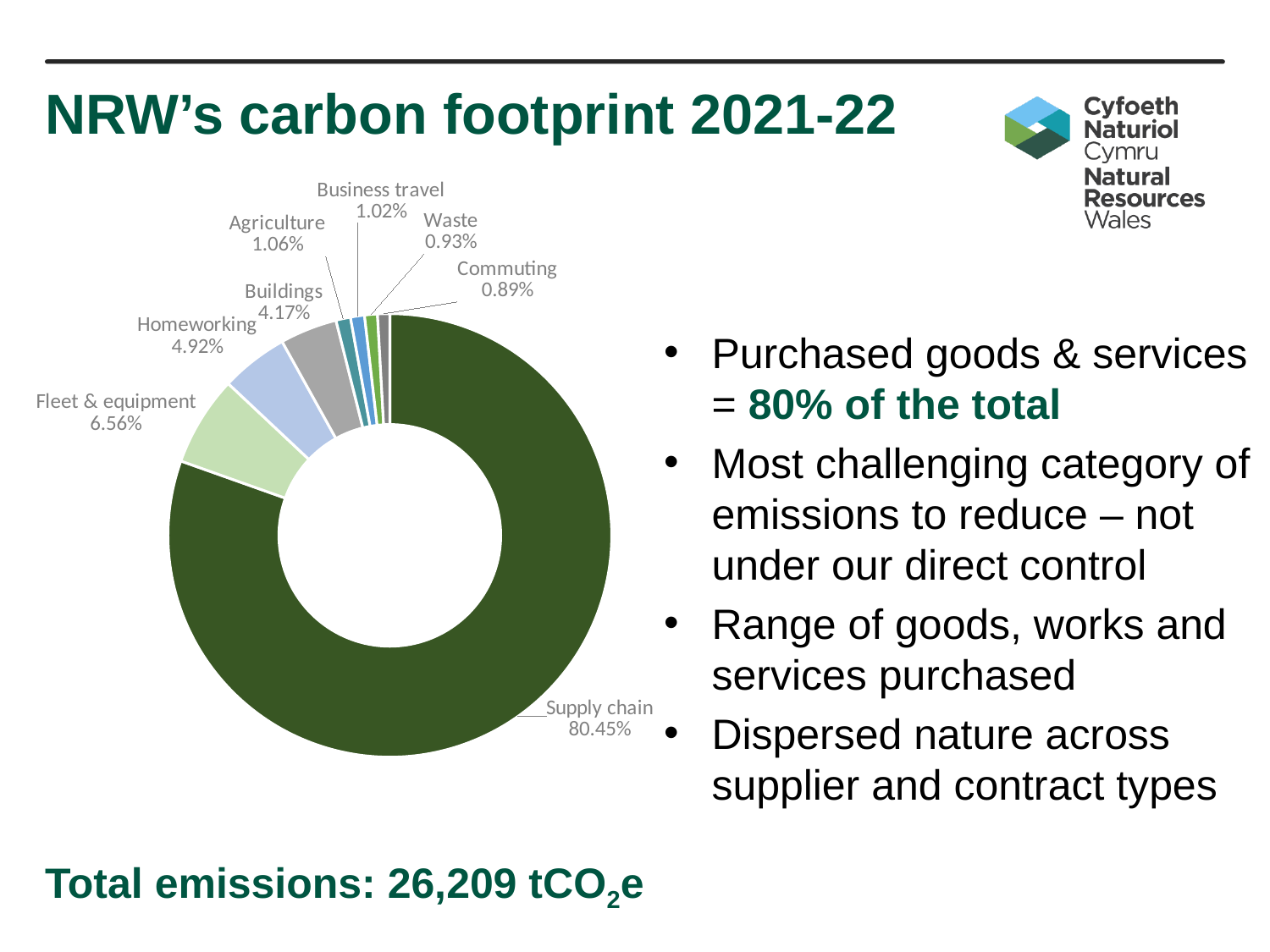
How many categories are shown in the chart? 8 What share of NRW's carbon footprint does Supply chain account for? 80.45% Which category has the smallest share of the carbon footprint? Commuting What percentage of the carbon footprint is Buildings? 4.17% What kind of chart is shown on the slide? Doughnut (pie) chart What percentage of the carbon footprint is Fleet & equipment? 6.56% What percentage of the carbon footprint is Commuting? 0.89% Which category has the largest share of the carbon footprint? Supply chain Which has a larger share, Agriculture or Business travel? Agriculture What is the difference in percentage points between Fleet & equipment and Homeworking? 1.64 What is the total emissions figure stated on the slide? 26,209 tCO2e What percentage of the carbon footprint is Homeworking? 4.92%